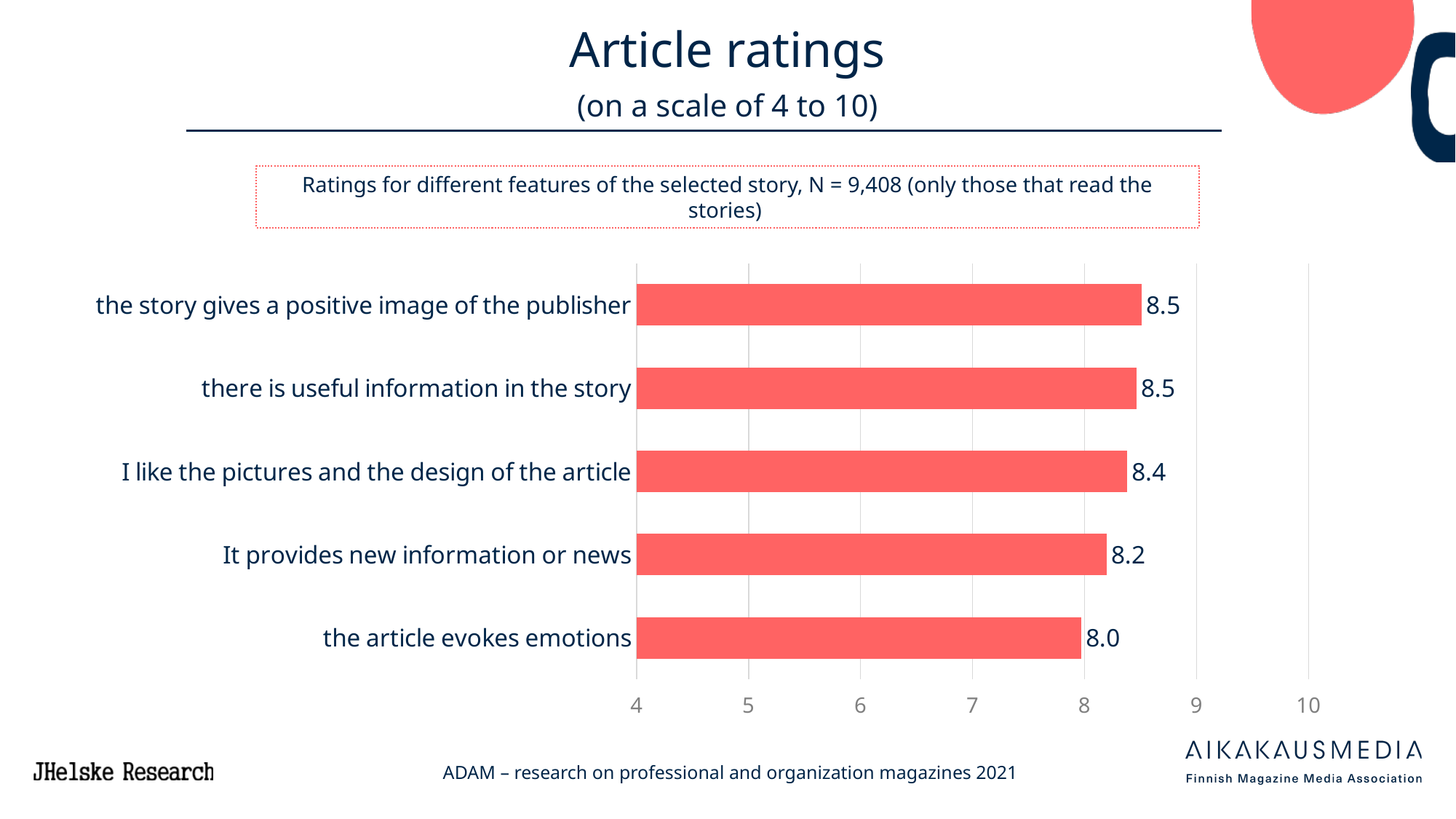
What is the rating for "the article evokes emotions"? 8.0 What is the difference between the rating for "the story gives a positive image of the publisher" and the rating for "the article evokes emotions"? 0.5 Is the rating for "It provides new information or news" greater or less than 9? less What is the rating for "It provides new information or news"? 8.2 Which feature has the lowest rating? the article evokes emotions How many features are rated in the chart? 5 What is the sample size (N) stated on the slide? 9,408 What is the title of the slide? Article ratings Which is rated higher: "I like the pictures and the design of the article" or "It provides new information or news"? I like the pictures and the design of the article What kind of chart is shown on the slide? bar chart What is the rating for "I like the pictures and the design of the article"? 8.4 What is the rating for "there is useful information in the story"? 8.5